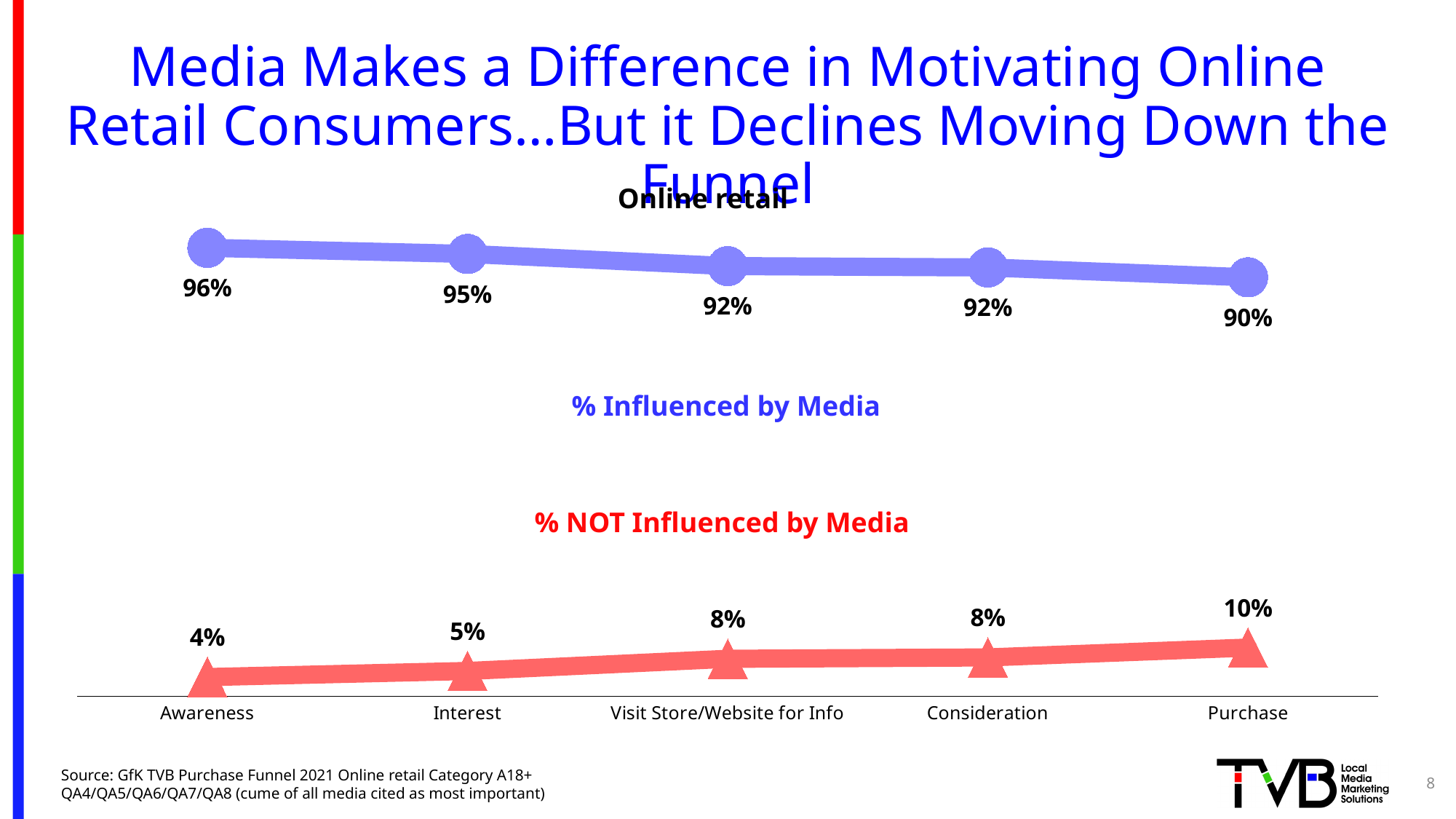
What is the difference between % Influenced by Media at Awareness and at Purchase? 6% What is the value of % Influenced by Media at the Consideration stage? 92% At which stage is % Influenced by Media lowest? Purchase Which is larger: % NOT Influenced by Media at Visit Store/Website for Info or at Interest? Visit Store/Website for Info Does % Influenced by Media rise or fall moving from Awareness to Purchase? Fall What is the value of % NOT Influenced by Media at the Purchase stage? 10% What kind of chart is shown on the slide? Line chart How many funnel stages are shown on the x axis? 5 What is the value of % NOT Influenced by Media at the Interest stage? 5% At which stage is % NOT Influenced by Media highest? Purchase What is the value of % Influenced by Media at the Awareness stage? 96% What is the difference between % NOT Influenced by Media at Purchase and at Awareness? 6%